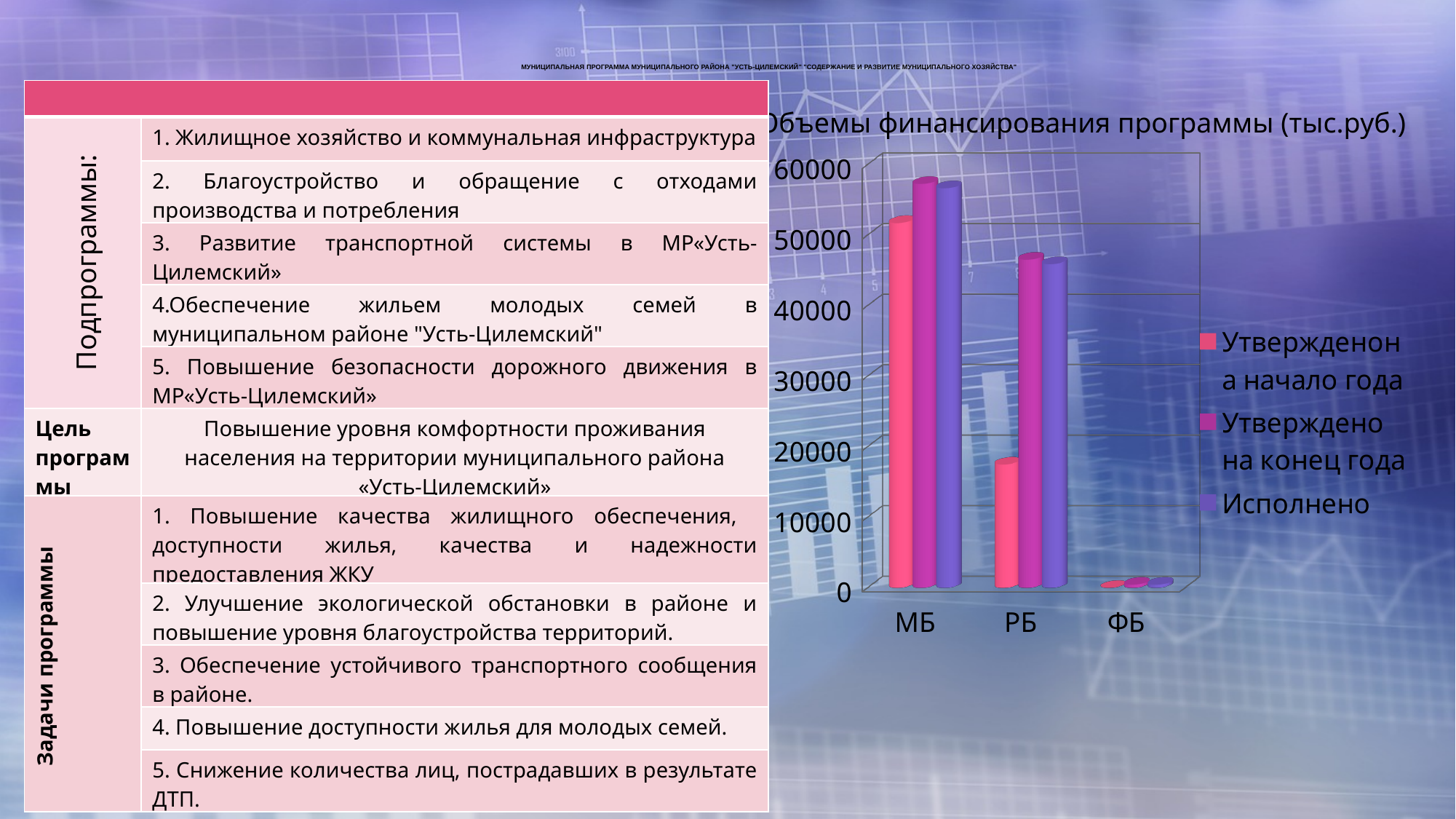
How many categories are shown on the x axis of the chart? 3 Which category has the highest value for the series "Исполнено"? МБ What type of chart is shown on the slide? bar chart Is the value for РБ in the series "Исполнено" greater or less than 40000? greater Which category has the lowest value for the series "Утверждено на конец года"? ФБ What is the title of the chart on the slide? Объемы финансирования программы (тыс.руб.) How many series does the chart legend list? 3 Is the value for МБ in the series "Утверждено на конец года" greater or less than 50000? greater Is the value for ФБ in the series "Исполнено" greater or less than 10000? less For the series "Утверждено на конец года", which is larger: МБ or РБ? МБ Do the values for the series "Исполнено" rise or fall from МБ to ФБ along the x axis? fall